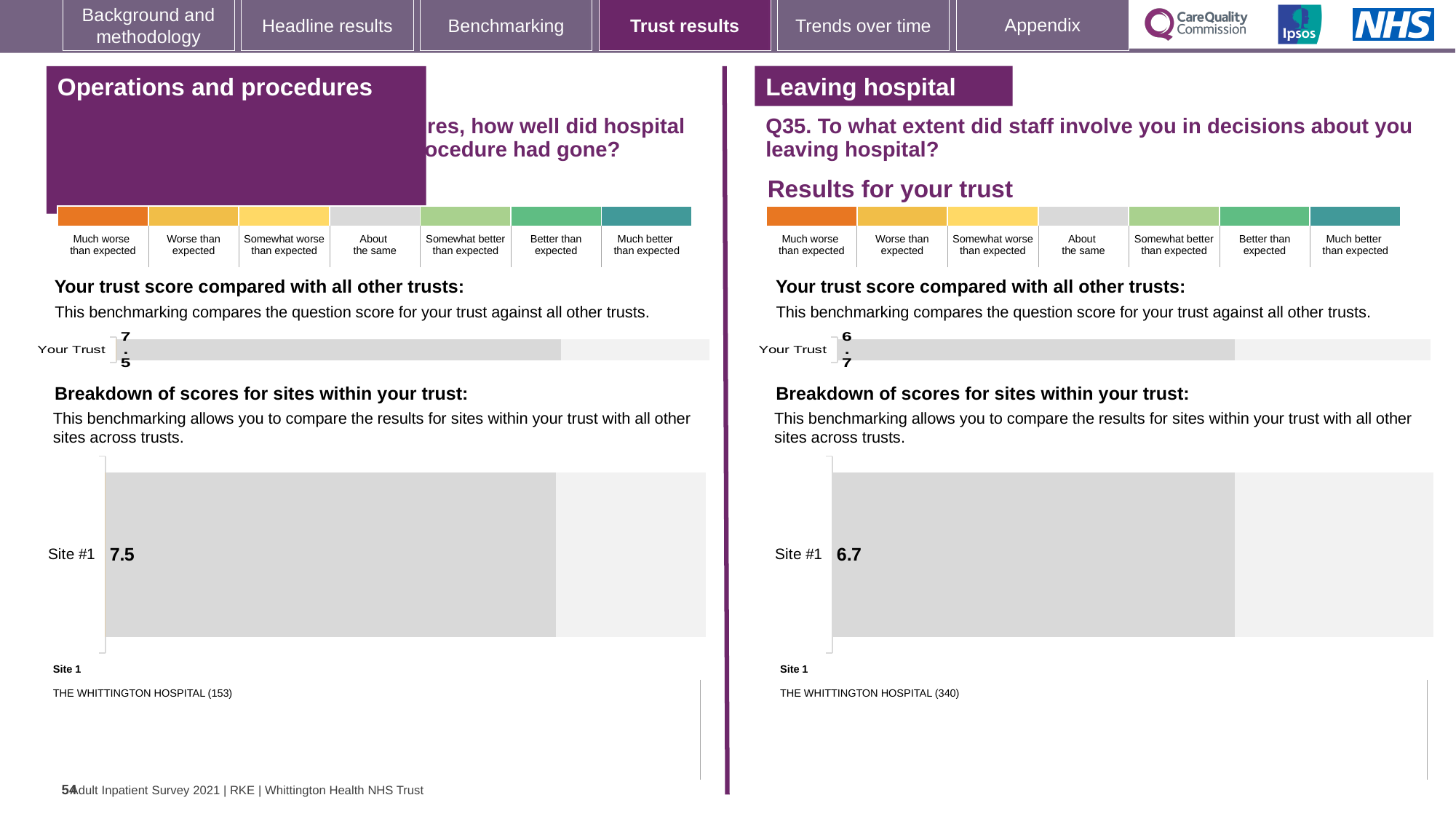
Which is larger: the Site #1 score in the left-hand 'Operations and procedures' breakdown chart or the Site #1 score in the right-hand 'Leaving hospital' breakdown chart? Operations and procedures (7.5) In the left-hand 'Breakdown of scores for sites within your trust' chart (Operations and procedures), what is the score for Site #1? 7.5 What is the difference between the 'Your Trust' score in the left-hand 'Operations and procedures' chart and the 'Your Trust' score in the right-hand 'Leaving hospital' chart? 0.8 What kind of chart is used for the 'Breakdown of scores for sites within your trust' section on the right-hand side? Bar chart How many sites are shown in the right-hand 'Breakdown of scores for sites within your trust' chart? 1 Which site name is listed as Site 1 beneath the left-hand 'Operations and procedures' breakdown chart? THE WHITTINGTON HOSPITAL (153) How many sites are shown in the left-hand 'Breakdown of scores for sites within your trust' chart? 1 On the left-hand 'Operations and procedures' section, what is the score shown for 'Your Trust' in the 'Your trust score compared with all other trusts' chart? 7.5 On the right-hand 'Leaving hospital' section, what is the score shown for 'Your Trust' in the 'Your trust score compared with all other trusts' chart? 6.7 In the right-hand 'Breakdown of scores for sites within your trust' chart (Leaving hospital), what is the score for Site #1? 6.7 What kind of chart is used for the 'Your trust score compared with all other trusts' section on the left-hand side? Bar chart Which site name is listed as Site 1 beneath the right-hand 'Leaving hospital' breakdown chart? THE WHITTINGTON HOSPITAL (340)